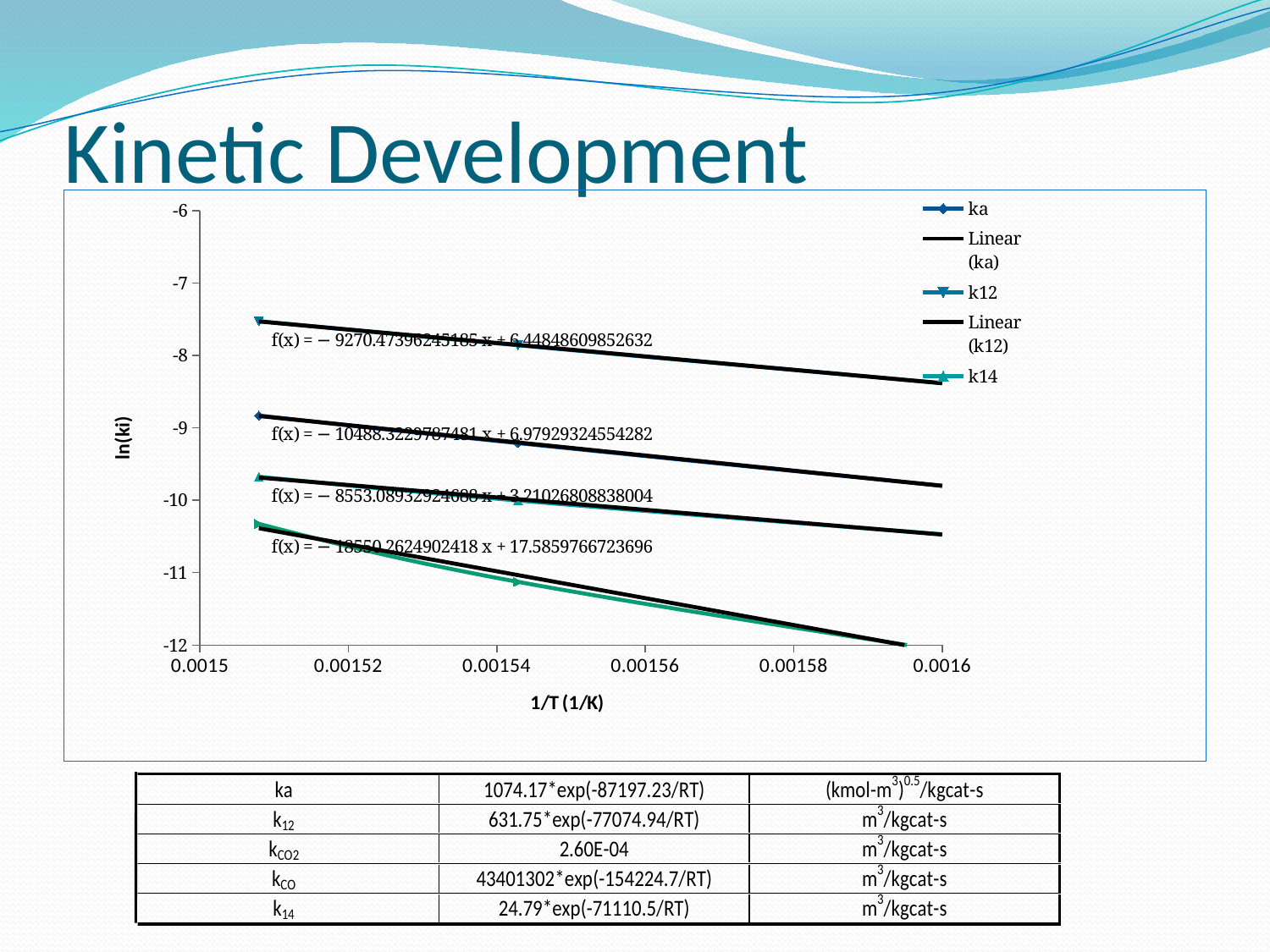
Of the series ka, k12 and k14, which has the highest ln(ki) values? k12 Is the value for k12 at 1/T = 0.00151 greater or less than -8? greater What kind of chart is shown on the slide? line chart At 1/T = 0.00151, which series has the higher ln(ki) value, ka or k12? k12 How many tick labels are shown on the x axis of the chart? 6 What is the title of the y axis of the chart? ln(ki) Is the value for ka at 1/T = 0.00151 greater or less than -8? less Of the series ka, k12 and k14, which has the lowest ln(ki) values? k14 What is the slope shown in the trendline equation f(x) = -9270.47396245185 x + 6.44848609852632? -9270.47396245185 What is the title of the x axis of the chart? 1/T (1/K) Do the plotted ln(ki) values rise or fall as 1/T increases along the x axis? fall Is the value for k14 at 1/T = 0.00151 greater or less than -9? less